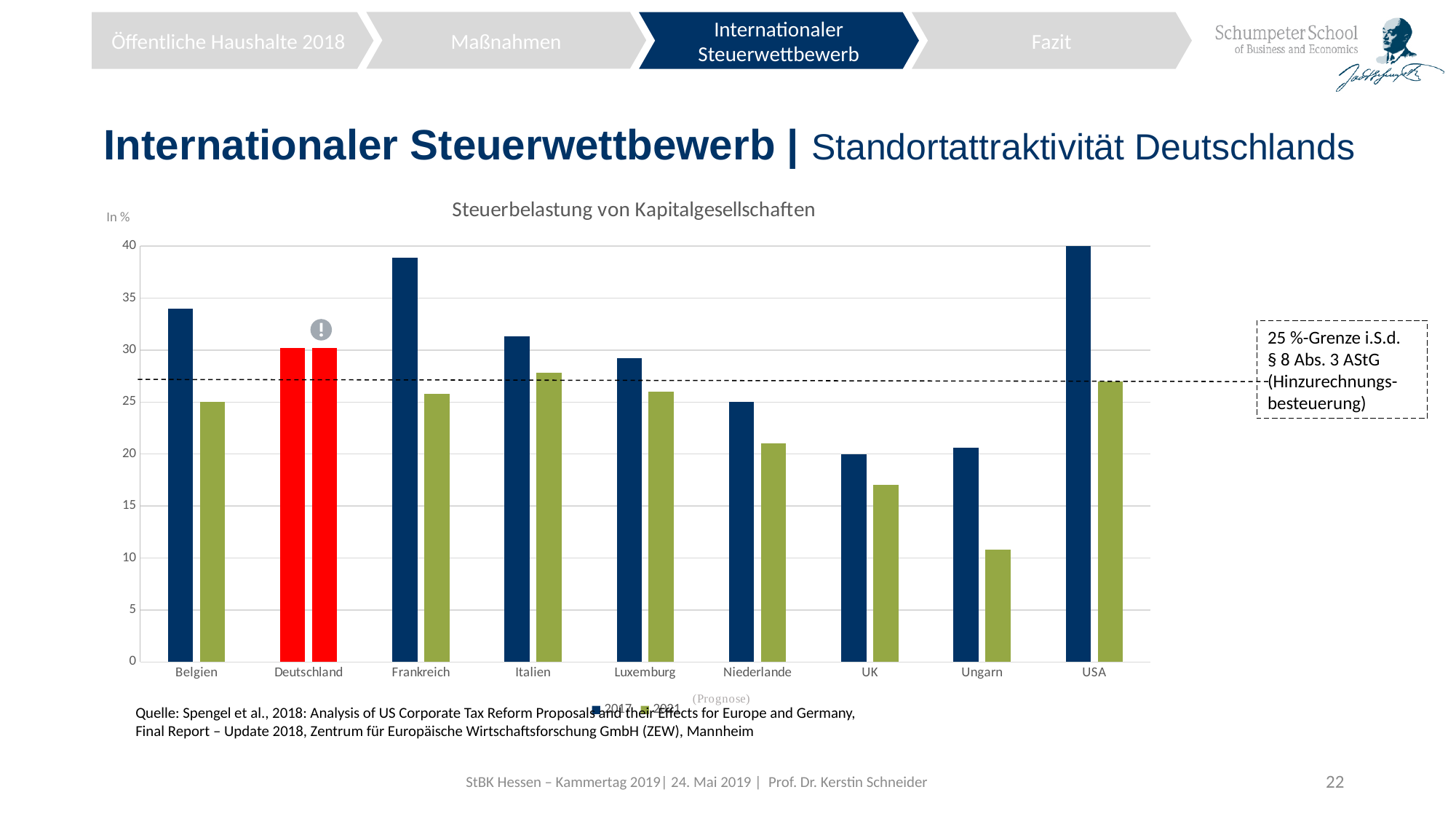
Is the dark blue bar for Frankreich greater or less than 35? greater Is the green bar for Ungarn greater or less than 15? less Which country has the highest green bar in the chart? Italien Which country has the lowest green bar in the chart? Ungarn Which is larger: the dark blue bar for Belgien or the dark blue bar for Frankreich? Frankreich Is the dark blue bar for Belgien greater or less than 30? greater Which country's bars are highlighted in red in the chart? Deutschland How many countries are shown on the x axis of the chart? 9 For Ungarn, which bar is larger: the dark blue bar or the green bar? the dark blue bar What is the title of the chart? Steuerbelastung von Kapitalgesellschaften What kind of chart is shown on the slide? bar chart